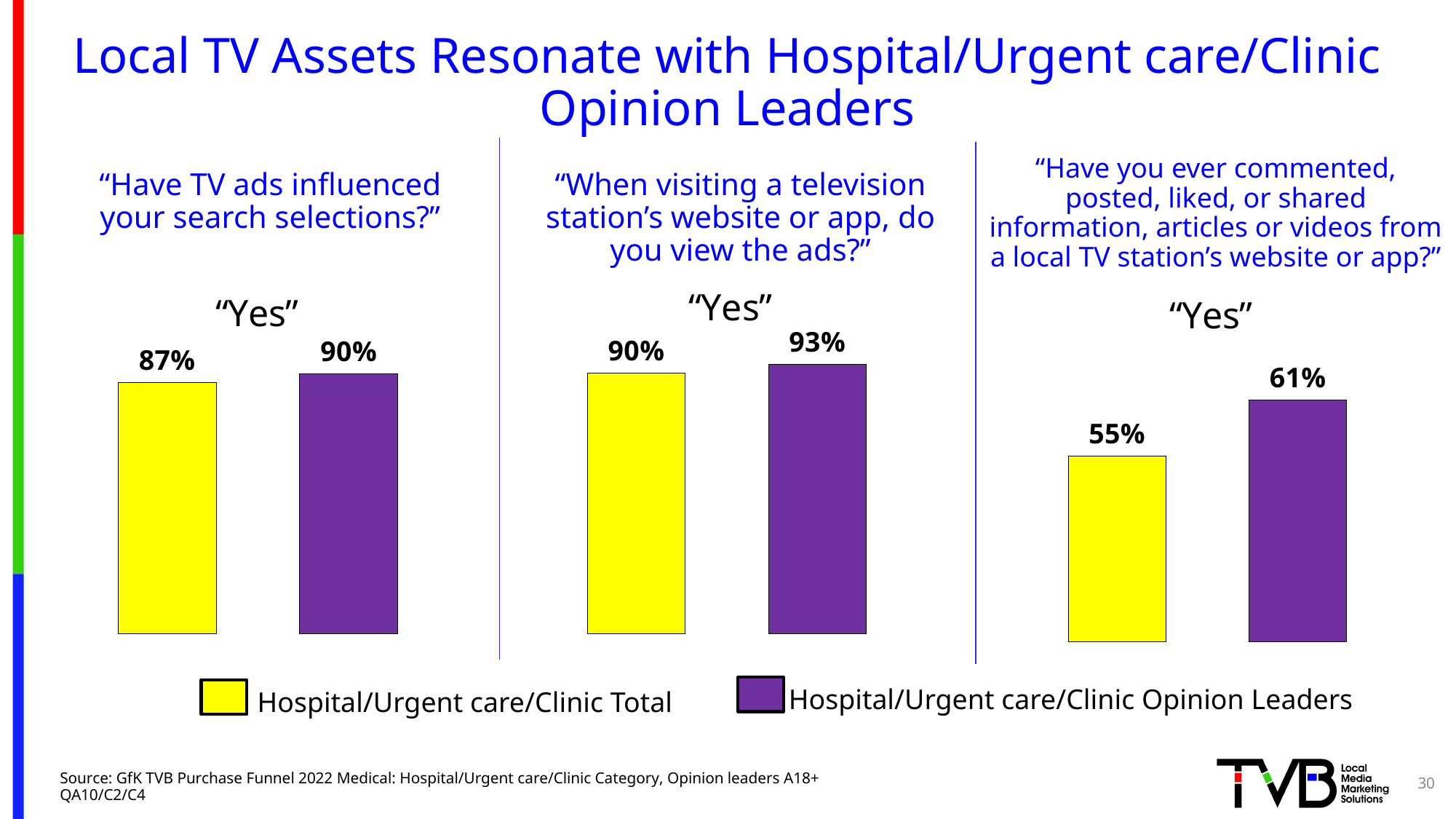
How many series does the legend list? 2 In the left chart ("Have TV ads influenced your search selections?"), which group has the higher value? Hospital/Urgent care/Clinic Opinion Leaders What colour represents Hospital/Urgent care/Clinic Total in the legend? Yellow What kind of chart is the middle chart ("When visiting a television station's website or app, do you view the ads?")? Bar chart In the right chart ("Have you ever commented, posted, liked, or shared..."), what is the difference between the Opinion Leaders value and the Total value? 6% In the right chart ("Have you ever commented, posted, liked, or shared..."), what is the value for Hospital/Urgent care/Clinic Opinion Leaders? 61% In the left chart ("Have TV ads influenced your search selections?"), what is the value for Hospital/Urgent care/Clinic Total? 87% In the middle chart ("When visiting a television station's website or app, do you view the ads?"), what is the difference between the Opinion Leaders value and the Total value? 3% In the middle chart ("When visiting a television station's website or app, do you view the ads?"), what is the value for Hospital/Urgent care/Clinic Opinion Leaders? 93% In the left chart ("Have TV ads influenced your search selections?"), what is the value for Hospital/Urgent care/Clinic Opinion Leaders? 90% In the right chart ("Have you ever commented, posted, liked, or shared..."), which group has the lower value? Hospital/Urgent care/Clinic Total In the right chart ("Have you ever commented, posted, liked, or shared..."), what is the value for Hospital/Urgent care/Clinic Total? 55%